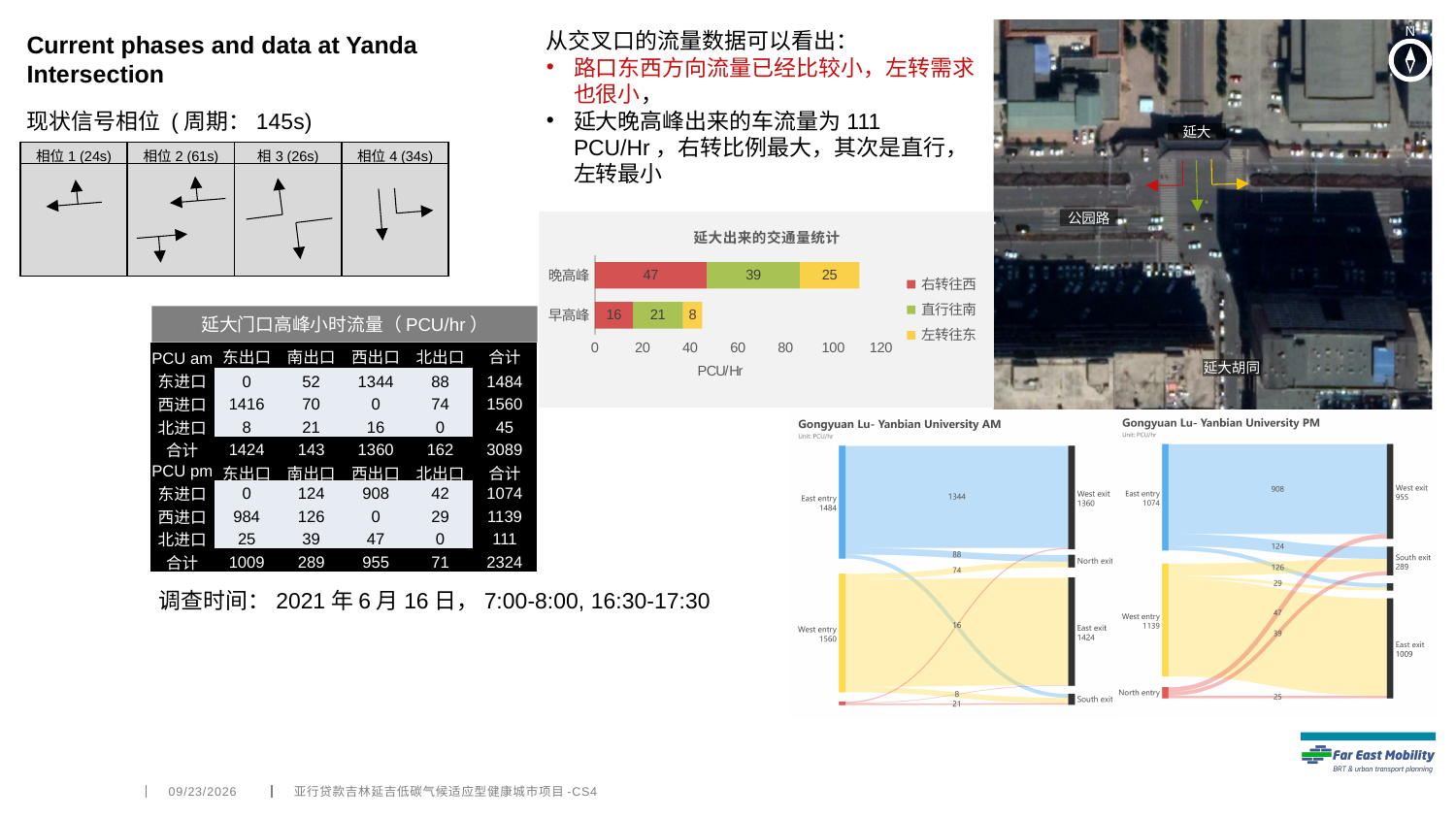
In the chart titled 延大出来的交通量统计, what is the difference between the 右转往西 values for 晚高峰 and 早高峰? 31 In the chart titled 延大出来的交通量统计, what is the x-axis label? PCU/Hr In the chart titled 延大出来的交通量统计, what is the value of 直行往南 for 早高峰? 21 In the chart titled 延大出来的交通量统计, how many series does the legend list? 3 In the chart titled 延大出来的交通量统计, what is the total of the stacked bar for 早高峰? 45 In the chart titled 延大出来的交通量统计, which series has the largest value for 晚高峰? 右转往西 In the chart titled 延大出来的交通量统计, what is the value of 右转往西 for 晚高峰? 47 In the chart titled 延大出来的交通量统计, what is the total of the stacked bar for 晚高峰? 111 In the chart titled 延大出来的交通量统计, what is the value of 左转往东 for 晚高峰? 25 In the chart titled 延大出来的交通量统计, which series has the smallest value for 早高峰? 左转往东 What kind of chart is the chart titled 延大出来的交通量统计? Stacked bar chart In the chart titled 延大出来的交通量统计, what is the value of 左转往东 for 早高峰? 8